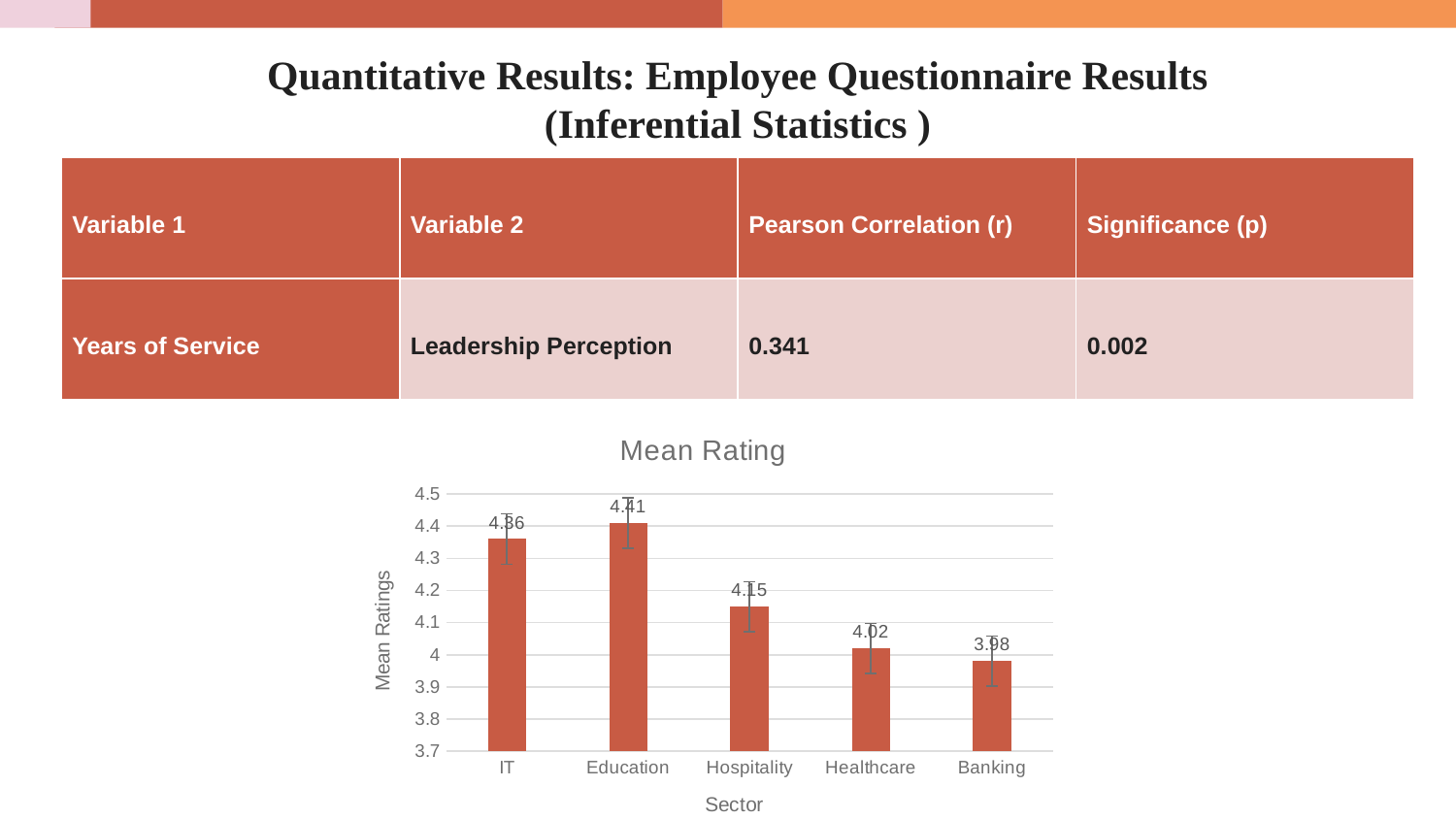
What is the difference between the mean ratings of IT and Hospitality? 0.21 Is the mean rating for Healthcare greater or less than 4.1? less What type of chart is used to show the mean ratings? Bar chart What is the mean rating for the Banking sector? 3.98 What is the label of the x axis of the chart? Sector Which sector has a higher mean rating, Hospitality or Healthcare? Hospitality What is the difference between the mean ratings of Education and Banking? 0.43 Which sector has the lowest mean rating? Banking How many sectors are shown in the chart? 5 What is the mean rating for the Hospitality sector? 4.15 Which sector has the highest mean rating? Education What is the mean rating for the Education sector? 4.41